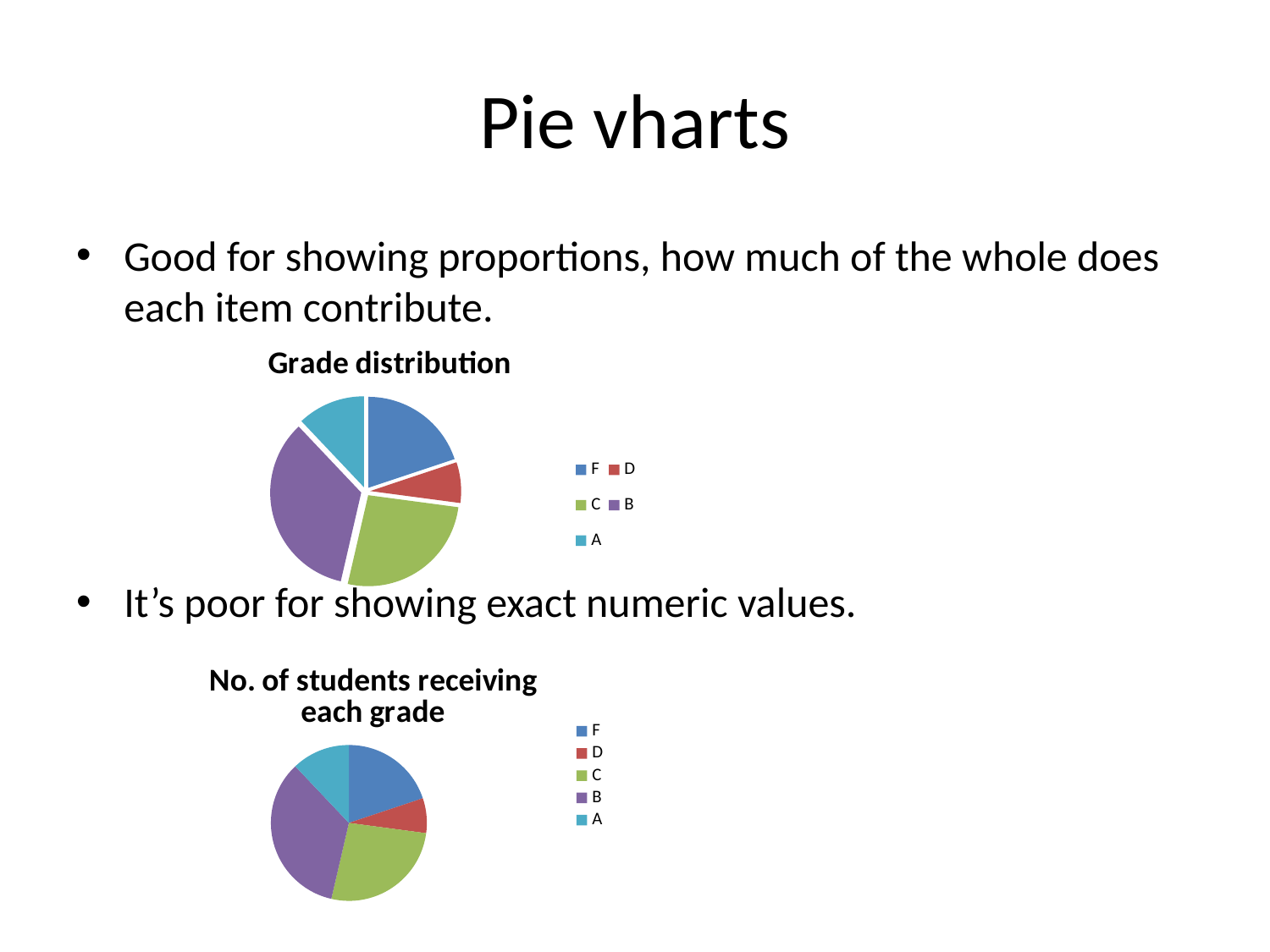
What kind of chart is the chart titled "No. of students receiving each grade"? pie chart What kind of chart is the chart titled "Grade distribution"? pie chart What is the title of the lower pie chart on the slide? No. of students receiving each grade In the "Grade distribution" chart, what colour is the slice for grade B? purple In the "No. of students receiving each grade" chart, which slice is larger, F or D? F In the "No. of students receiving each grade" chart, which grade has the smallest slice? D How many entries does the legend of the "No. of students receiving each grade" chart list? 5 How many slices does the "Grade distribution" pie chart have? 5 In the "Grade distribution" chart, which slice is larger, C or A? C In the "Grade distribution" chart, which grade has the largest slice? B In the "Grade distribution" chart, which grade has the smallest slice? D In the "No. of students receiving each grade" chart, which grade has the largest slice? B